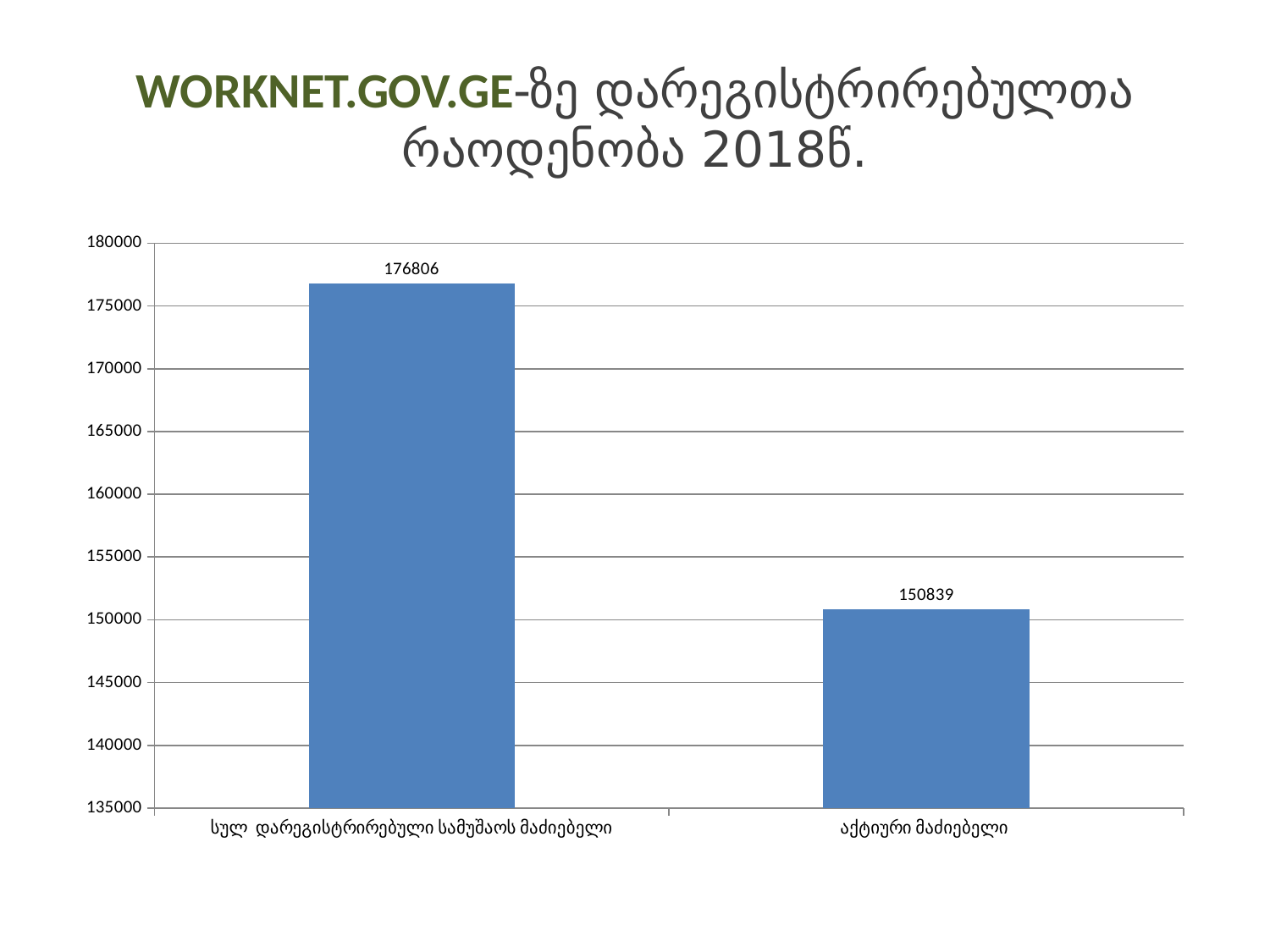
How many categories are shown in the chart? 2 Which is larger: the value for აქტიური მაძიებელი or the value for სულ დარეგისტრირებული სამუშაოს მაძიებელი? სულ დარეგისტრირებული სამუშაოს მაძიებელი What year is mentioned in the slide title? 2018 What is the lowest value shown on the vertical axis? 135000 Which category has the highest value? სულ დარეგისტრირებული სამუშაოს მაძიებელი What kind of chart is shown on the slide? bar chart Which category has the lowest value? აქტიური მაძიებელი Is the value for აქტიური მაძიებელი greater or less than 155000? less What is the value for აქტიური მაძიებელი? 150839 What is the value for სულ დარეგისტრირებული სამუშაოს მაძიებელი? 176806 What is the difference between the value for სულ დარეგისტრირებული სამუშაოს მაძიებელი and the value for აქტიური მაძიებელი? 25967 Is the value for სულ დარეგისტრირებული სამუშაოს მაძიებელი greater or less than 175000? greater